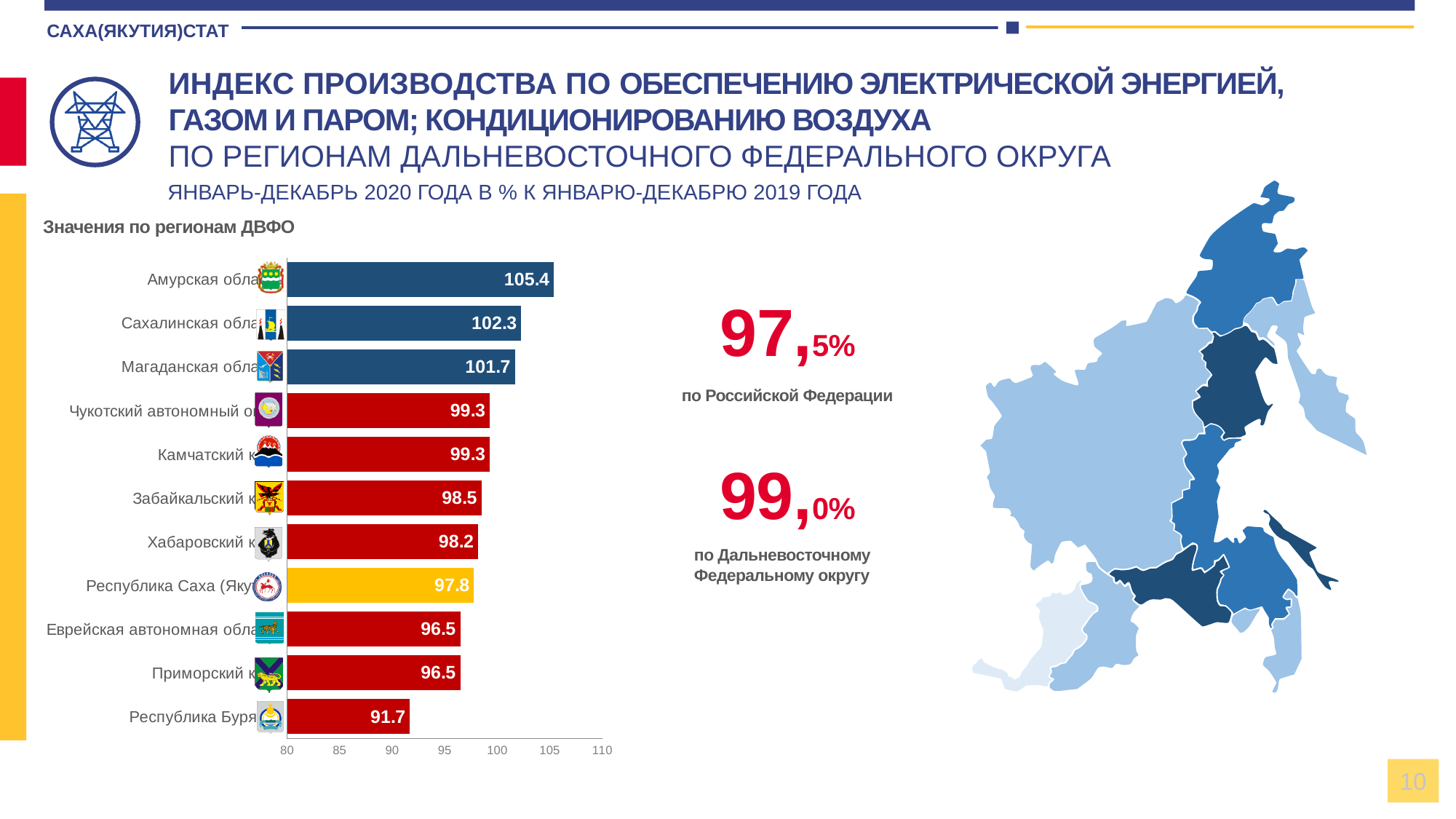
What is the difference between the values for Сахалинская область and Магаданская область? 0.6 Which region has the highest value on the chart? Амурская область Which is larger, the value for Забайкальский край or the value for Еврейская автономная область? Забайкальский край What kind of chart is shown on the slide? bar chart Which region's bar is coloured yellow on the chart? Республика Саха (Якутия) What is the value for Хабаровский край? 98.2 How many regions are shown on the bar chart? 11 What is the value for Амурская область? 105.4 Is the value for Магаданская область greater or less than 100? greater What is the value for Республика Саха (Якутия)? 97.8 Which region has the lowest value on the chart? Республика Бурятия What is the difference between the values for Амурская область and Республика Бурятия? 13.7